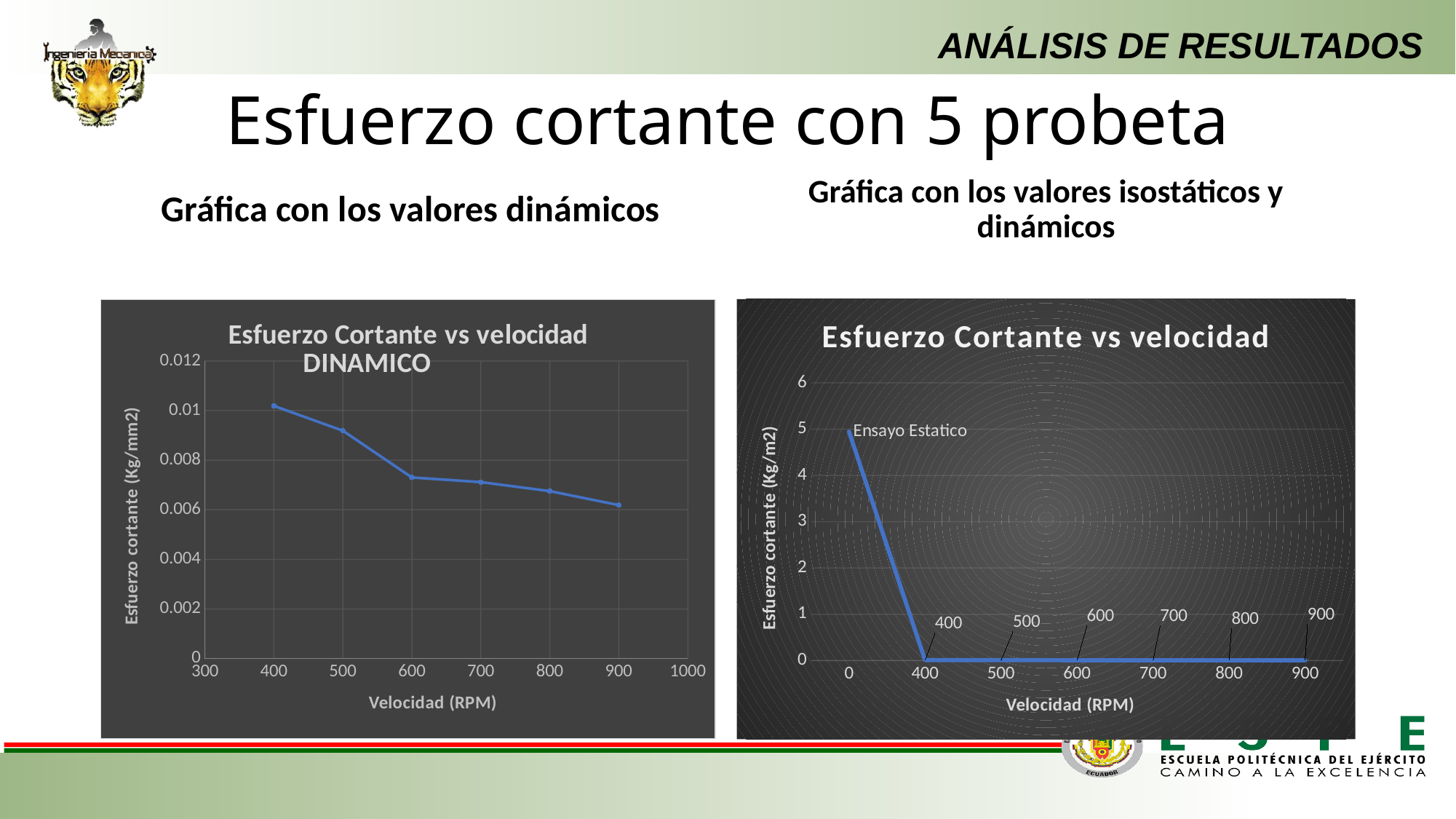
What is the x-axis title of the left chart 'Esfuerzo Cortante vs velocidad DINAMICO'? Velocidad (RPM) In the left chart 'Esfuerzo Cortante vs velocidad DINAMICO', which is larger, the value at 500 RPM or the value at 800 RPM? 500 RPM In the left chart 'Esfuerzo Cortante vs velocidad DINAMICO', at which velocity (RPM) is the shear stress lowest? 900 In the left chart 'Esfuerzo Cortante vs velocidad DINAMICO', at which velocity (RPM) is the shear stress highest? 400 In the left chart 'Esfuerzo Cortante vs velocidad DINAMICO', is the value at 500 RPM greater or less than 0.008? greater In the left chart 'Esfuerzo Cortante vs velocidad DINAMICO', is the value at 600 RPM greater or less than 0.008? less In the right chart 'Esfuerzo Cortante vs velocidad', which point has the highest shear stress? Ensayo Estatico What is the y-axis title of the right chart 'Esfuerzo Cortante vs velocidad'? Esfuerzo cortante (Kg/m2) What kind of chart is the left chart, 'Esfuerzo Cortante vs velocidad DINAMICO'? line chart In the left chart 'Esfuerzo Cortante vs velocidad DINAMICO', do the values rise or fall as velocity increases from 400 to 900 RPM? fall In the right chart 'Esfuerzo Cortante vs velocidad', is the value labelled 'Ensayo Estatico' greater or less than 4? greater In the left chart 'Esfuerzo Cortante vs velocidad DINAMICO', how many data points are plotted? 6